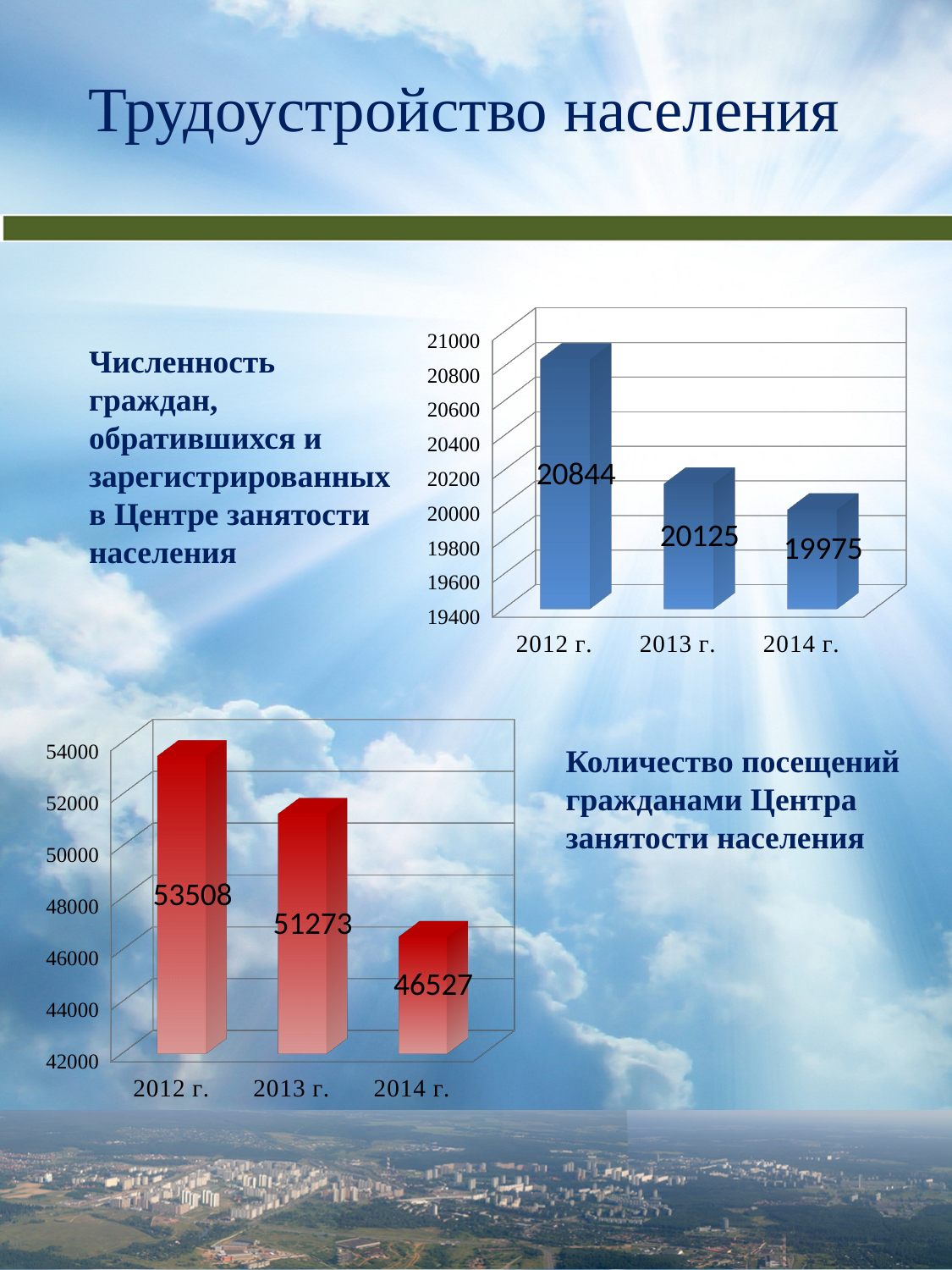
In the bottom chart (red bars), do the values rise or fall from 2012 г. to 2014 г.? fall In the top chart (blue bars), what is the value for 2014 г.? 19975 In the top chart (blue bars), is the value for 2014 г. greater or less than 20000? less In the bottom chart (red bars), which year has the lowest value? 2014 г. What type of chart is the top chart on the slide? bar chart In the top chart (blue bars), what is the value for 2012 г.? 20844 In the bottom chart (red bars), what is the value for 2013 г.? 51273 In the top chart (blue bars), which year has the highest value? 2012 г. In the bottom chart (red bars), which is larger: the value for 2013 г. or 2014 г.? 2013 г. In the top chart (blue bars), what is the difference between the values for 2012 г. and 2013 г.? 719 In the bottom chart (red bars), what is the difference between the values for 2012 г. and 2014 г.? 6981 How many years are shown in the bottom chart (red bars)? 3